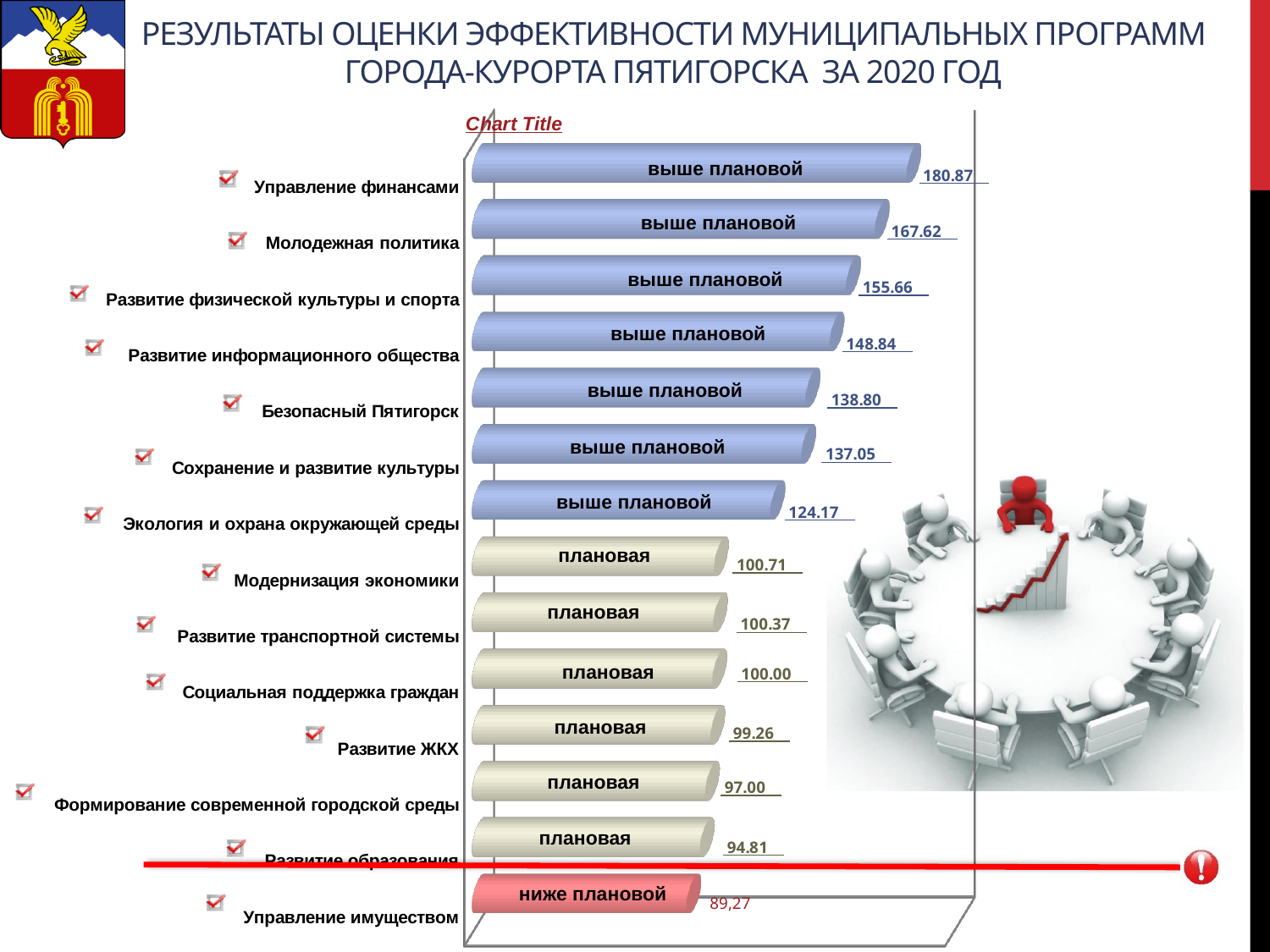
How many programmes (categories) are plotted in the chart? 14 What is the value shown for Безопасный Пятигорск? 138.80 What is the value shown for Управление финансами? 180.87 What is the value shown for Социальная поддержка граждан? 100.00 Do the values rise or fall going from the top bar to the bottom bar? fall Which programme has the lowest value in the chart? Управление имуществом What type of chart is shown on the slide? bar chart What is the difference between the values for Управление финансами and Молодежная политика? 13.25 Which has a larger value: Развитие ЖКХ or Развитие образования? Развитие ЖКХ What is the value shown for Управление имуществом? 89,27 Which programme has the highest value in the chart? Управление финансами What label is written on the bar for Управление имуществом? ниже плановой